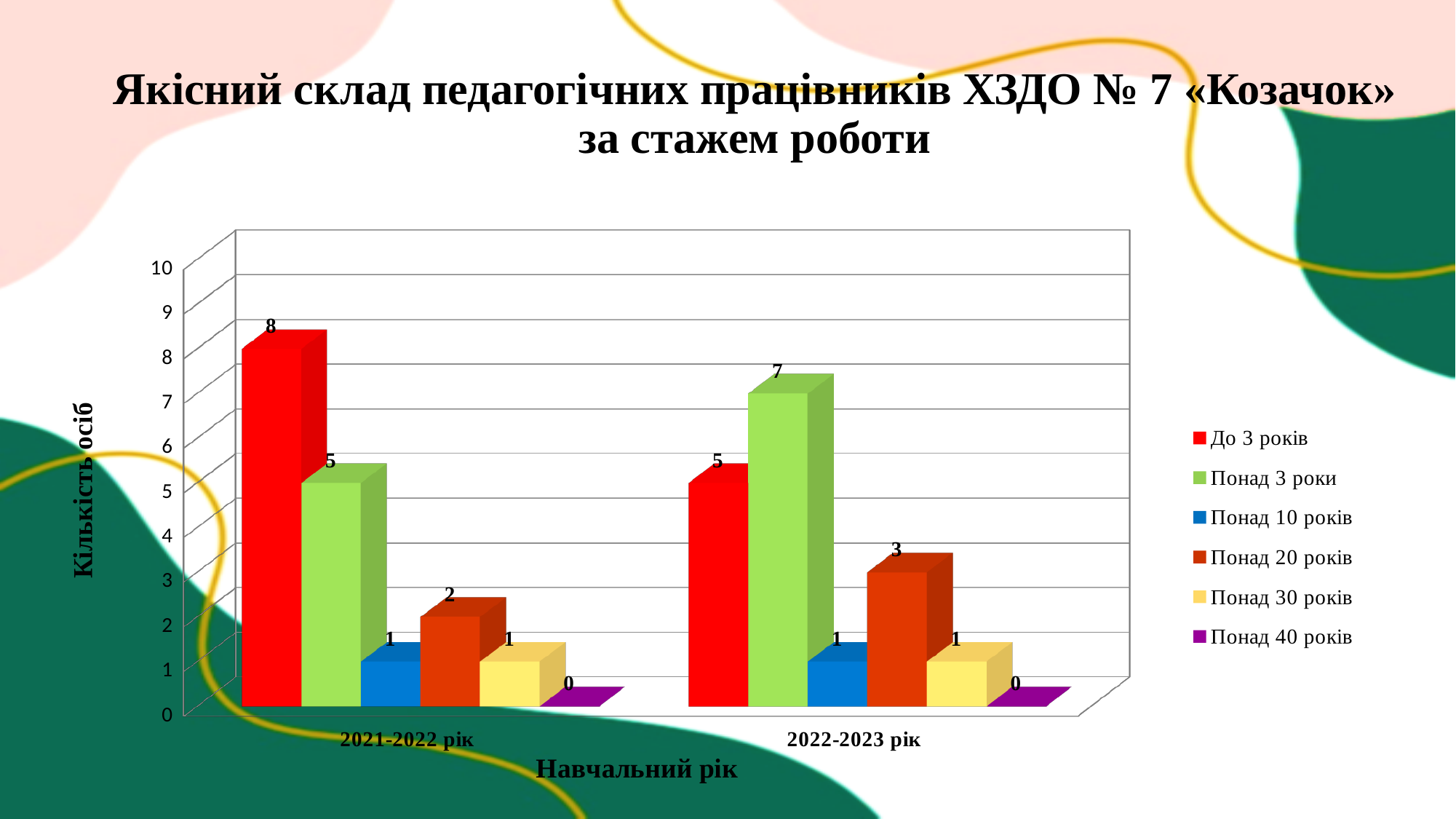
What is the label of the y axis? Кількість осіб Which series has the lowest value in 2022-2023 рік? Понад 40 років Which series has the highest value in 2021-2022 рік? До 3 років What is the value for "Понад 3 роки" in 2022-2023 рік? 7 What kind of chart is shown on the slide? Bar chart How many series does the legend list? 6 How many categories are shown on the x axis? 2 What is the value for "До 3 років" in 2021-2022 рік? 8 What is the value for "Понад 20 років" in 2022-2023 рік? 3 What is the difference between the "До 3 років" values for 2021-2022 рік and 2022-2023 рік? 3 Which is larger: "Понад 3 роки" in 2021-2022 рік or "Понад 3 роки" in 2022-2023 рік? 2022-2023 рік What is the value for "Понад 40 років" in 2021-2022 рік? 0